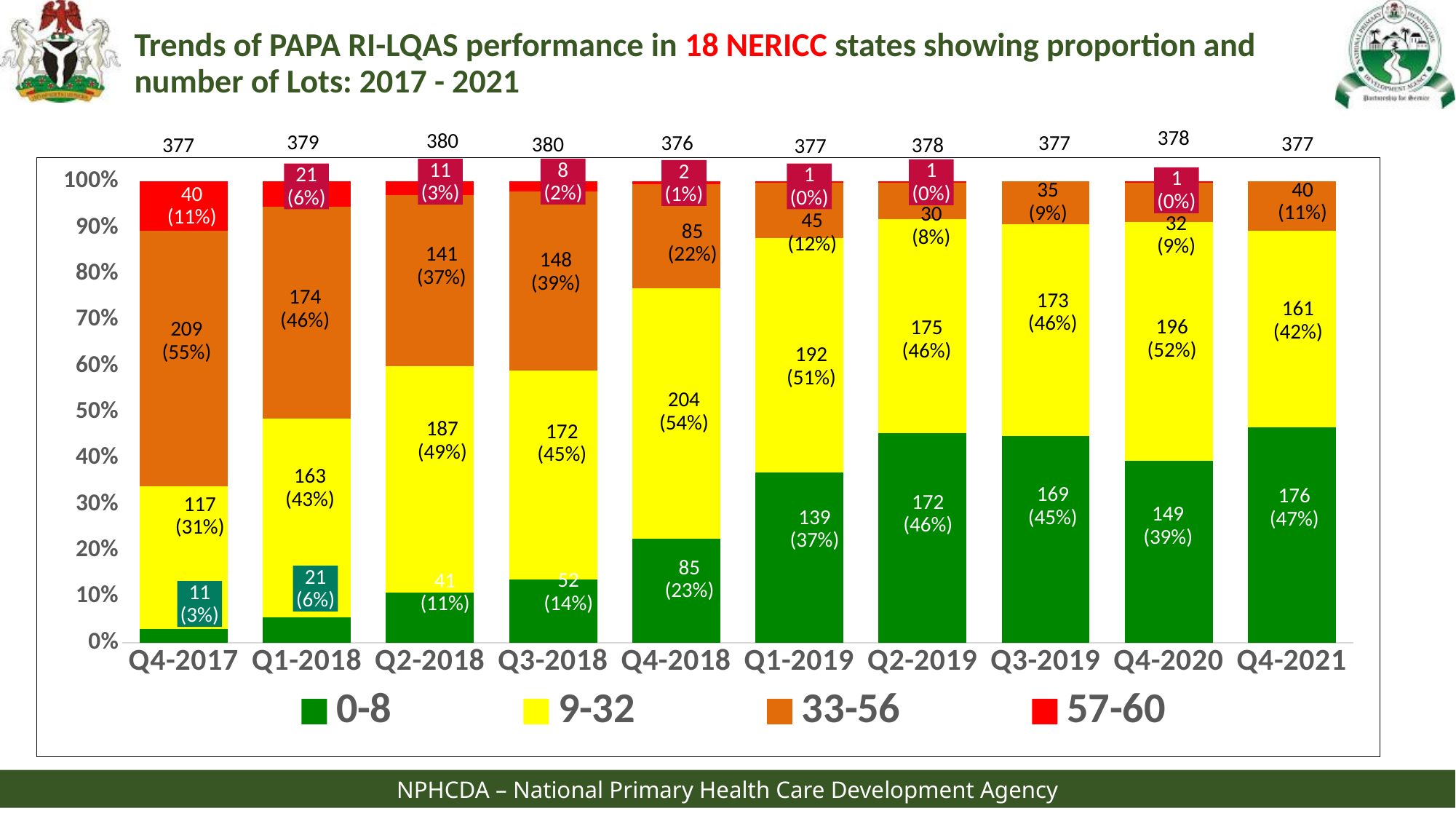
Which quarter has the highest number of lots in the 33-56 category? Q4-2017 What is the number of lots in the 33-56 category for Q1-2018? 174 (46%) What is the total number of lots shown above the bar for Q4-2018? 376 Which quarter has more lots in the 9-32 category, Q2-2018 or Q3-2018? Q2-2018 How many series does the legend list? 4 What is the number of lots in the 9-32 category for Q4-2018? 204 (54%) What is the number of lots in the 0-8 category for Q4-2017? 11 (3%) What percentage of lots in Q1-2019 fall in the 9-32 category? 51% What is the difference between the 33-56 and 9-32 lot counts in Q4-2017? 92 Which quarter has the highest number of lots in the 0-8 category? Q4-2021 How many quarters are shown along the x axis? 10 What kind of chart is shown on the slide? Stacked bar chart